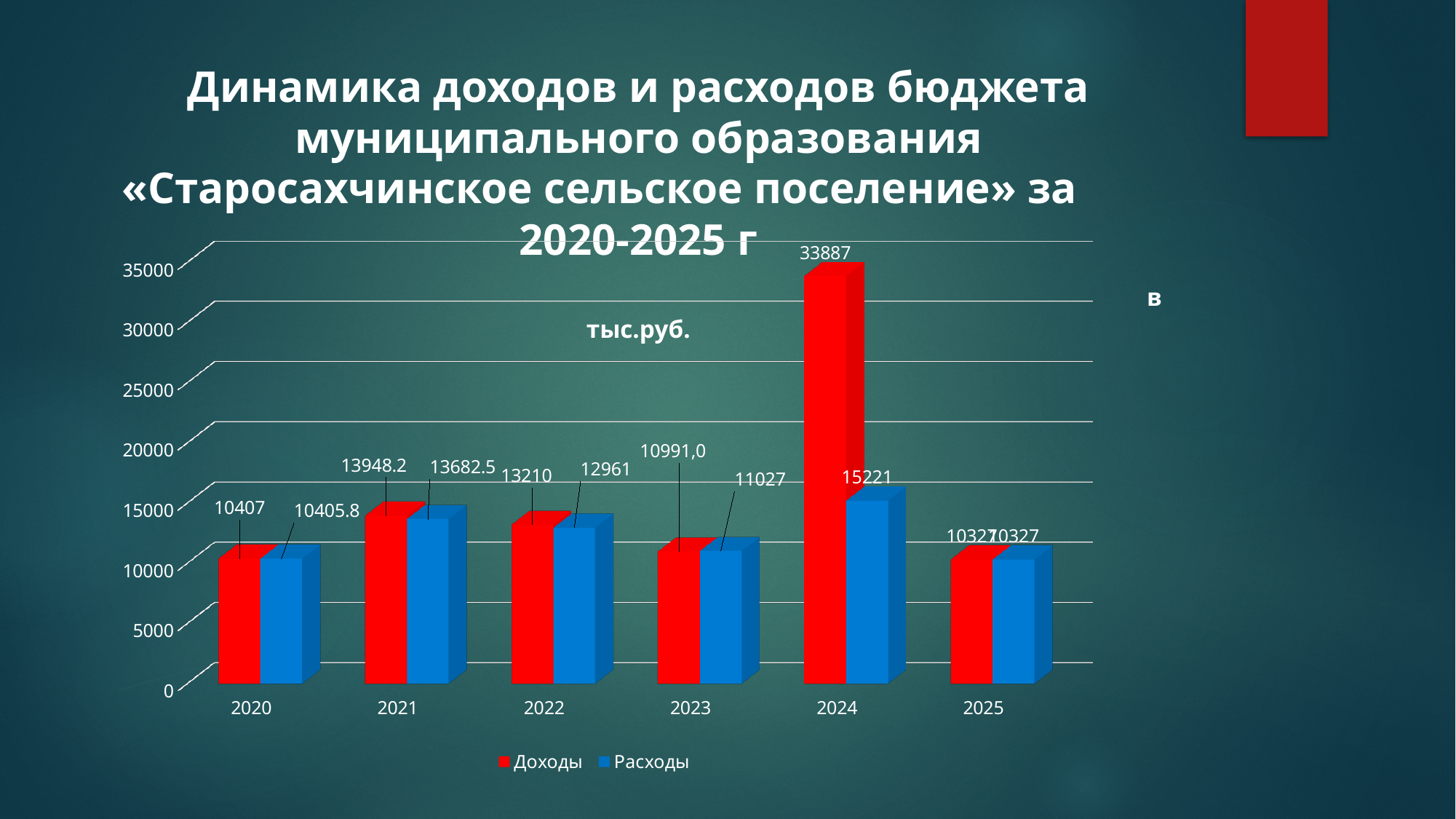
How many years are shown on the x axis? 6 What is the value of Доходы for 2024? 33887 What is the value of Расходы for 2023? 11027 In which year is Расходы the highest? 2024 What is the value of Доходы for 2020? 10407 In which year is Доходы the highest? 2024 What is the difference between Доходы and Расходы in 2024? 18666 What type of chart is shown on the slide? bar chart What is the value of Расходы for 2021? 13682.5 Is the value of Доходы for 2024 greater or less than 30000? greater How many series does the legend list? 2 Which is larger in 2022, Доходы or Расходы? Доходы